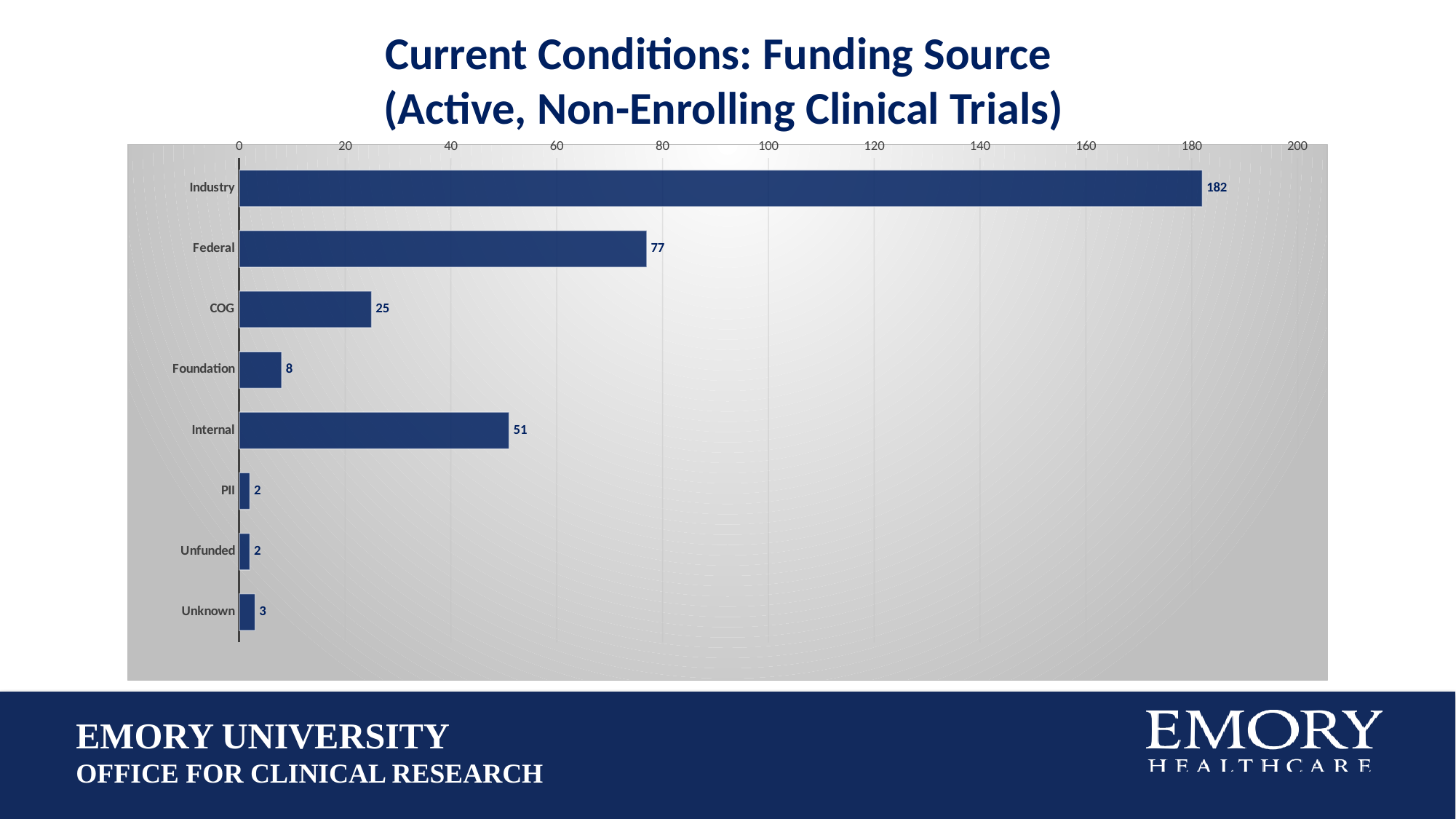
What kind of chart is shown on the slide? bar chart What is the value for Federal? 77 Is the value for Federal greater or less than 80? less What is the value for Internal? 51 Which is larger, the value for COG or the value for Internal? Internal What is the value for Foundation? 8 What is the title of the chart on the slide? Current Conditions: Funding Source (Active, Non-Enrolling Clinical Trials) What is the difference between the values for Industry and Federal? 105 What is the value for Industry? 182 How many funding source categories are shown on the chart? 8 Which funding source has the highest value? Industry What is the difference between the values for Internal and COG? 26